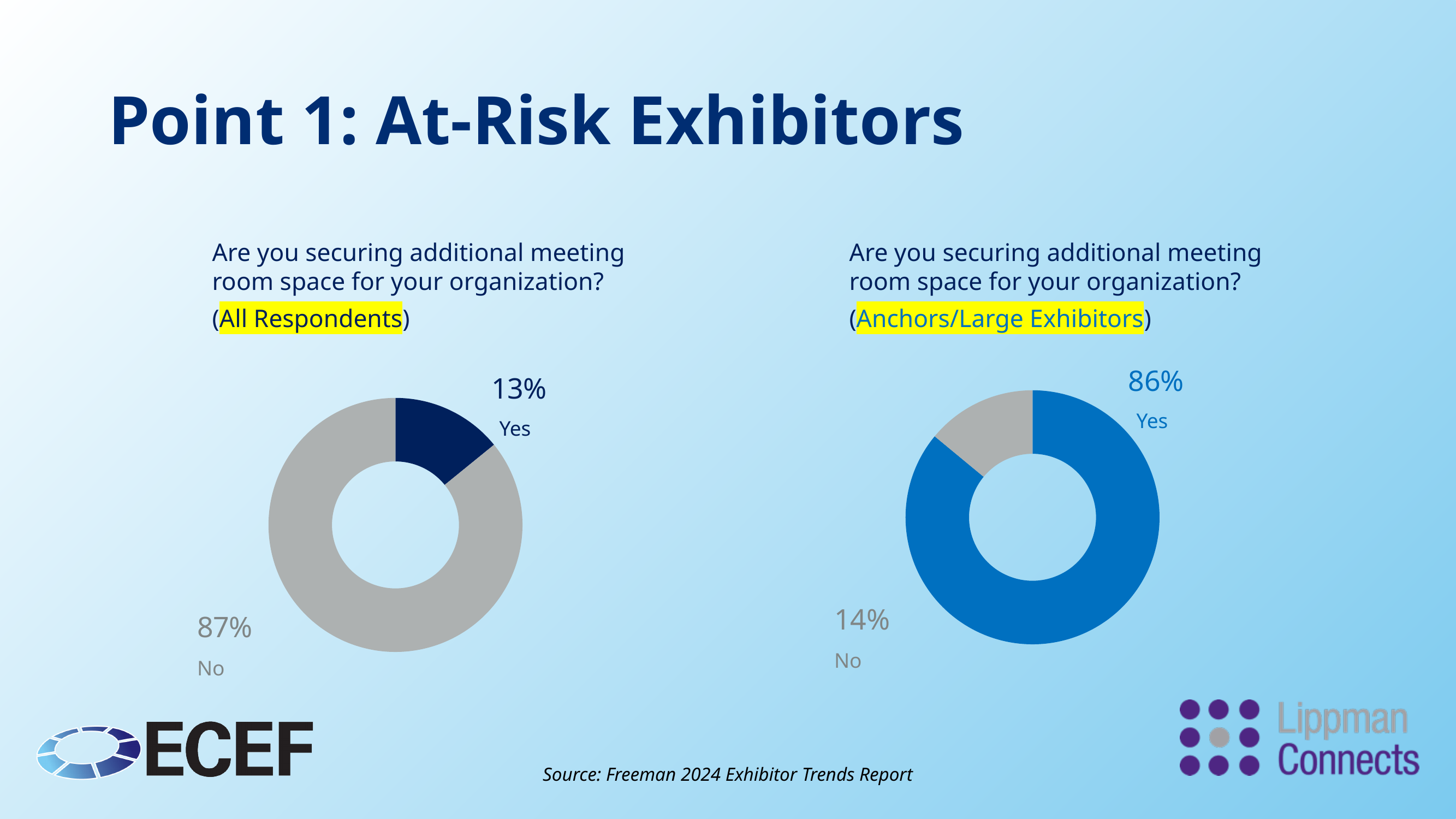
Which chart has the larger Yes share, All Respondents or Anchors/Large Exhibitors? Anchors/Large Exhibitors In the Anchors/Large Exhibitors chart, which response has the smaller share? No What colour is the Yes slice in the Anchors/Large Exhibitors chart? Blue In the All Respondents chart, which response has the larger share? No In the Anchors/Large Exhibitors chart, what percentage answered No? 14% In the All Respondents chart, what percentage answered Yes? 13% In the Anchors/Large Exhibitors chart, what percentage answered Yes? 86% What type of chart is used for the All Respondents data? Doughnut chart In the Anchors/Large Exhibitors chart, what is the difference between the Yes and No percentages? 72% In the All Respondents chart, what is the difference between the No and Yes percentages? 74% How many categories does the Anchors/Large Exhibitors chart show? 2 In the All Respondents chart, what percentage answered No? 87%